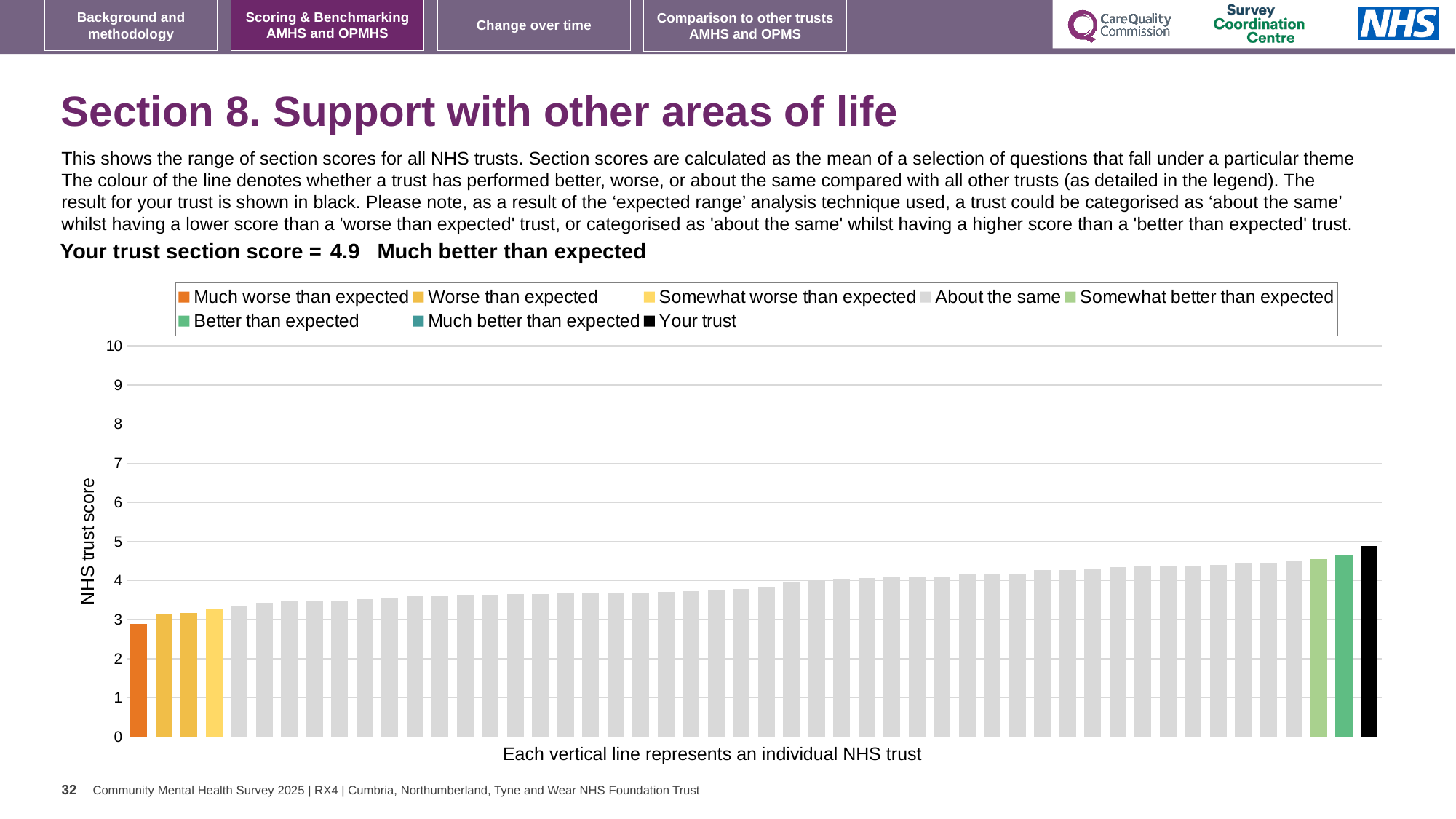
Is the value of the black 'Your trust' bar greater or less than 5? less What is the section score for your trust shown on the slide? 4.9 What is the label on the vertical axis of the chart? NHS trust score Which category does the slide say your trust's section score falls into? Much better than expected Do the bar values rise or fall from left to right across the chart? rise What kind of chart is shown on the slide? bar chart Which bar is the shortest in the chart? the orange 'Much worse than expected' bar Is the value of the orange 'Much worse than expected' bar greater or less than 4? less Which bar is the tallest in the chart? Your trust (black bar) Is the value of the black 'Your trust' bar greater or less than 4? greater How many entries does the chart legend list? 8